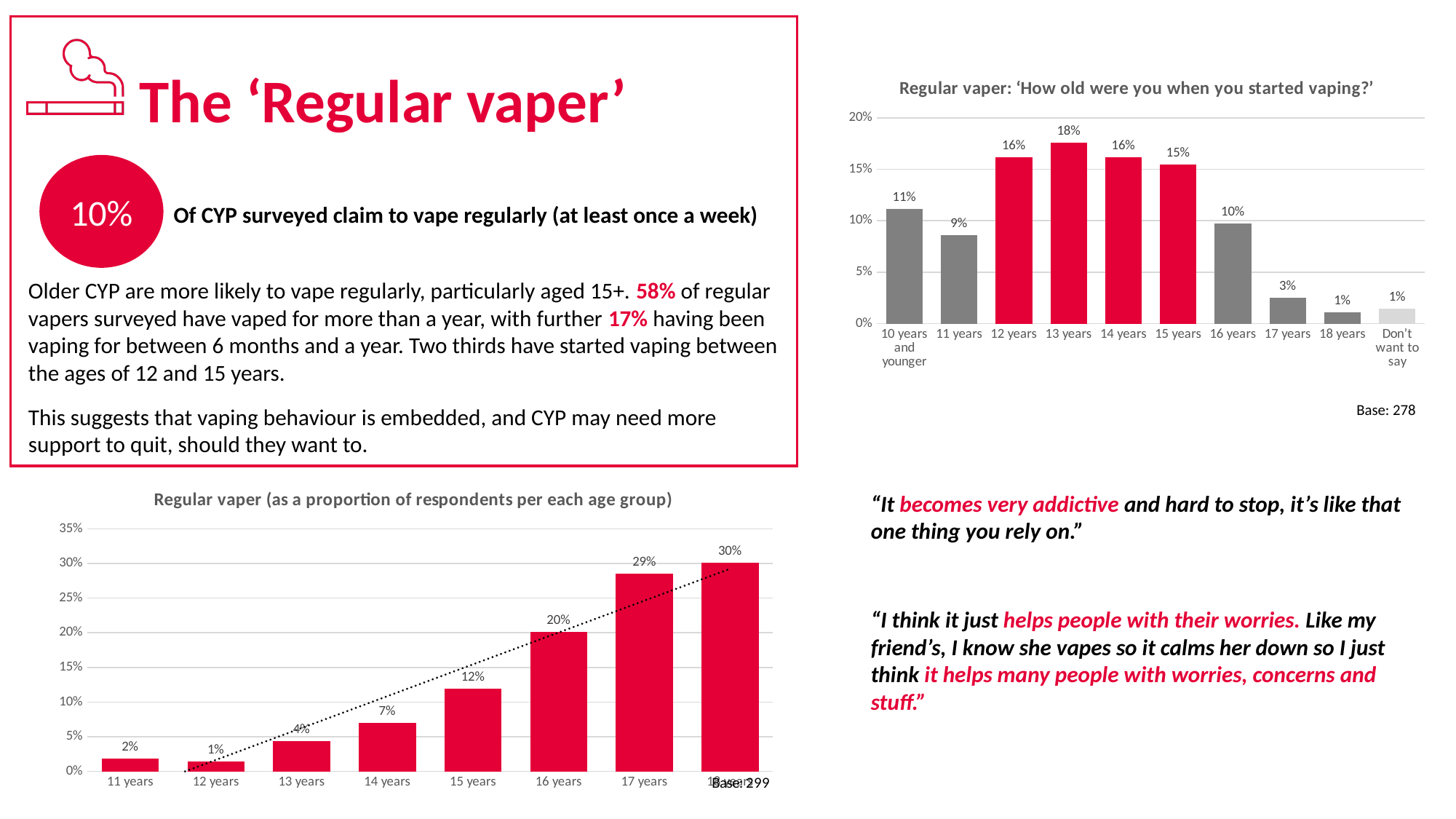
In the chart titled 'Regular vaper: How old were you when you started vaping?', how many categories are shown on the x axis? 10 In the chart titled 'Regular vaper (as a proportion of respondents per each age group)', what is the value for 15 years? 12% In the chart titled 'Regular vaper: How old were you when you started vaping?', which age category has the highest value? 13 years In the chart titled 'Regular vaper (as a proportion of respondents per each age group)', which age group has the lowest value? 12 years In the chart titled 'Regular vaper: How old were you when you started vaping?', what percentage started vaping at 10 years and younger? 11% In the chart titled 'Regular vaper: How old were you when you started vaping?', what percentage started vaping at 13 years? 18% What kind of chart is the one titled 'Regular vaper (as a proportion of respondents per each age group)'? bar chart In the chart titled 'Regular vaper (as a proportion of respondents per each age group)', what is the difference between the values for 16 years and 14 years? 13% In the chart titled 'Regular vaper: How old were you when you started vaping?', what is the difference between the values for 13 years and 16 years? 8% In the chart titled 'Regular vaper: How old were you when you started vaping?', which is larger, the value for 11 years or the value for 15 years? 15 years In the chart titled 'Regular vaper (as a proportion of respondents per each age group)', what is the value for 17 years? 29% In the chart titled 'Regular vaper (as a proportion of respondents per each age group)', do the values generally rise or fall as age increases? rise